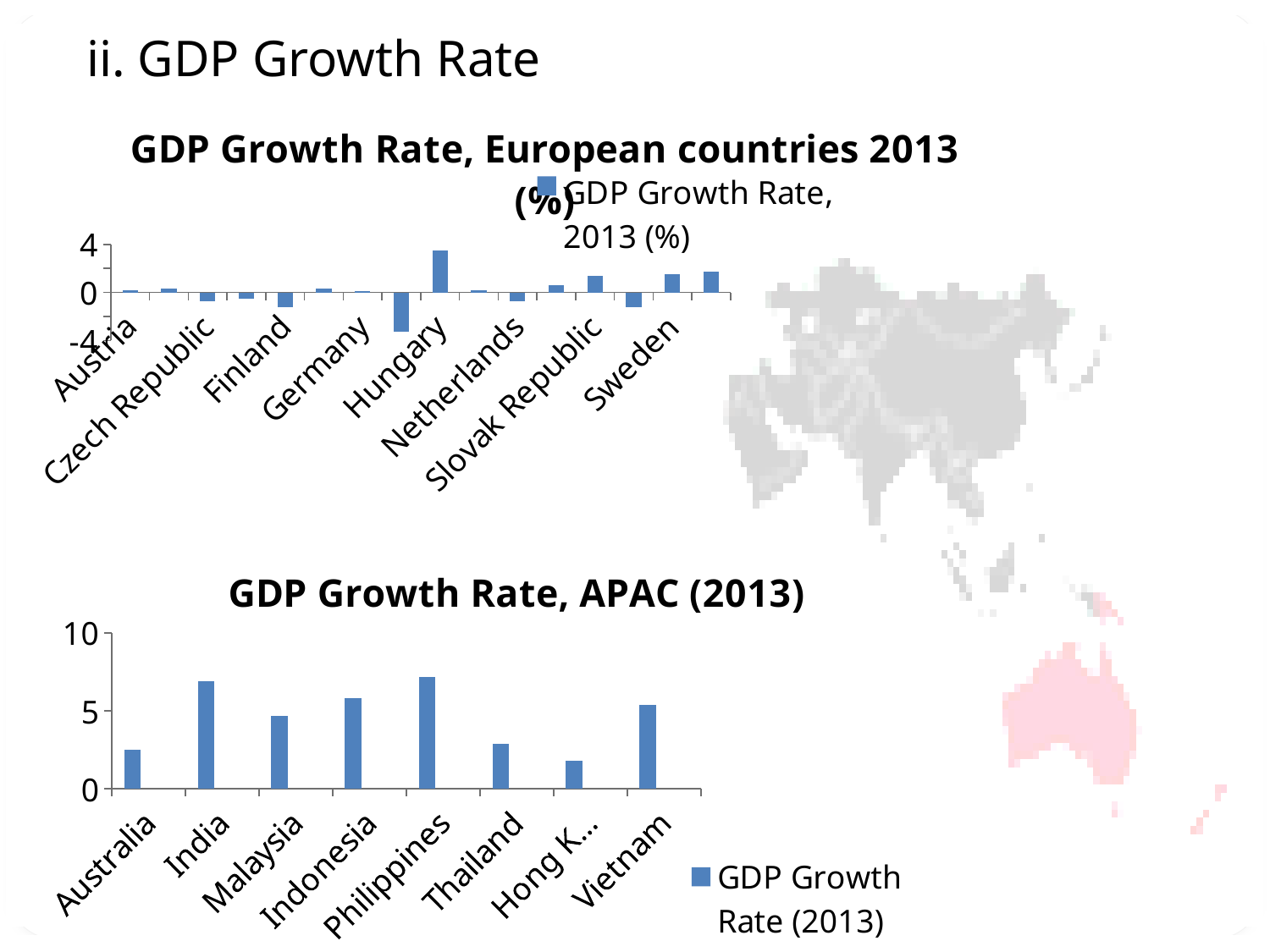
On the 'GDP Growth Rate, APAC (2013)' chart, is the value for Australia greater or less than 5? less On the 'GDP Growth Rate, European countries 2013 (%)' chart, is the value for Finland greater or less than 0? less On the 'GDP Growth Rate, European countries 2013 (%)' chart, which labelled country has the highest value? Hungary On the 'GDP Growth Rate, European countries 2013 (%)' chart, which has the larger value, Sweden or Netherlands? Sweden How many series does the legend of the 'GDP Growth Rate, APAC (2013)' chart list? 1 How many countries are shown on the 'GDP Growth Rate, APAC (2013)' chart? 8 What type of chart is the 'GDP Growth Rate, APAC (2013)' chart? bar chart On the 'GDP Growth Rate, APAC (2013)' chart, is the value for India greater or less than 5? greater On the 'GDP Growth Rate, APAC (2013)' chart, which has the larger value, Vietnam or Australia? Vietnam What is the legend entry on the 'GDP Growth Rate, APAC (2013)' chart? GDP Growth Rate (2013) On the 'GDP Growth Rate, APAC (2013)' chart, which has the larger value, Indonesia or Thailand? Indonesia